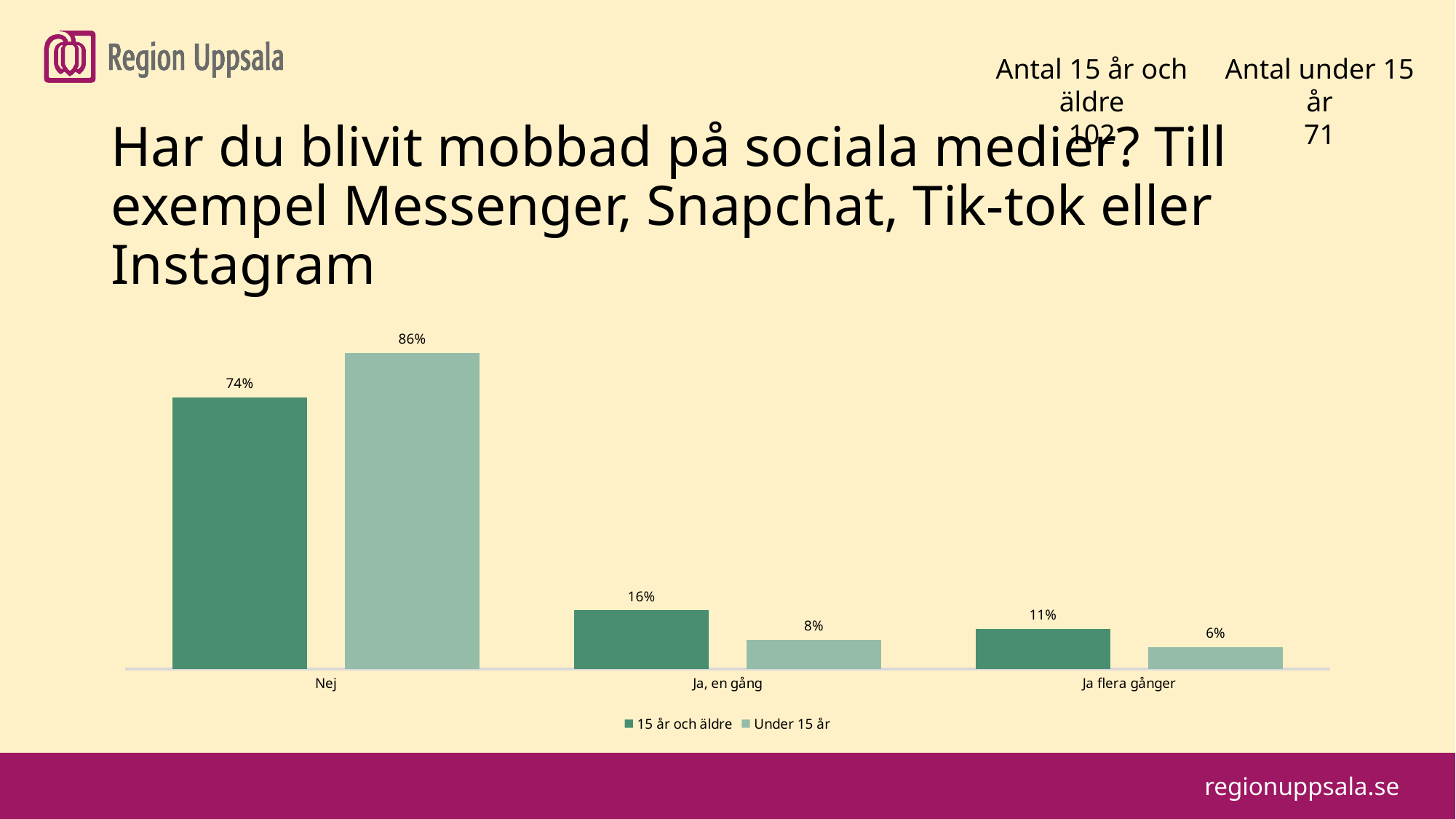
For "Ja, en gång", which series has the larger value: "15 år och äldre" or "Under 15 år"? 15 år och äldre How many categories are shown on the x axis? 3 What is the value for "Nej" in the "Under 15 år" series? 86% What is the value for "Ja flera gånger" in the "Under 15 år" series? 6% Which category has the highest value in the "Under 15 år" series? Nej What is the value for "Ja, en gång" in the "15 år och äldre" series? 16% Which category has the lowest value in the "15 år och äldre" series? Ja flera gånger How many series does the legend list? 2 What is the difference between the "Under 15 år" and "15 år och äldre" values for "Nej"? 12% What are the two series names listed in the legend? 15 år och äldre; Under 15 år What kind of chart is shown on the slide? Bar chart What is the value for "Nej" in the "15 år och äldre" series? 74%